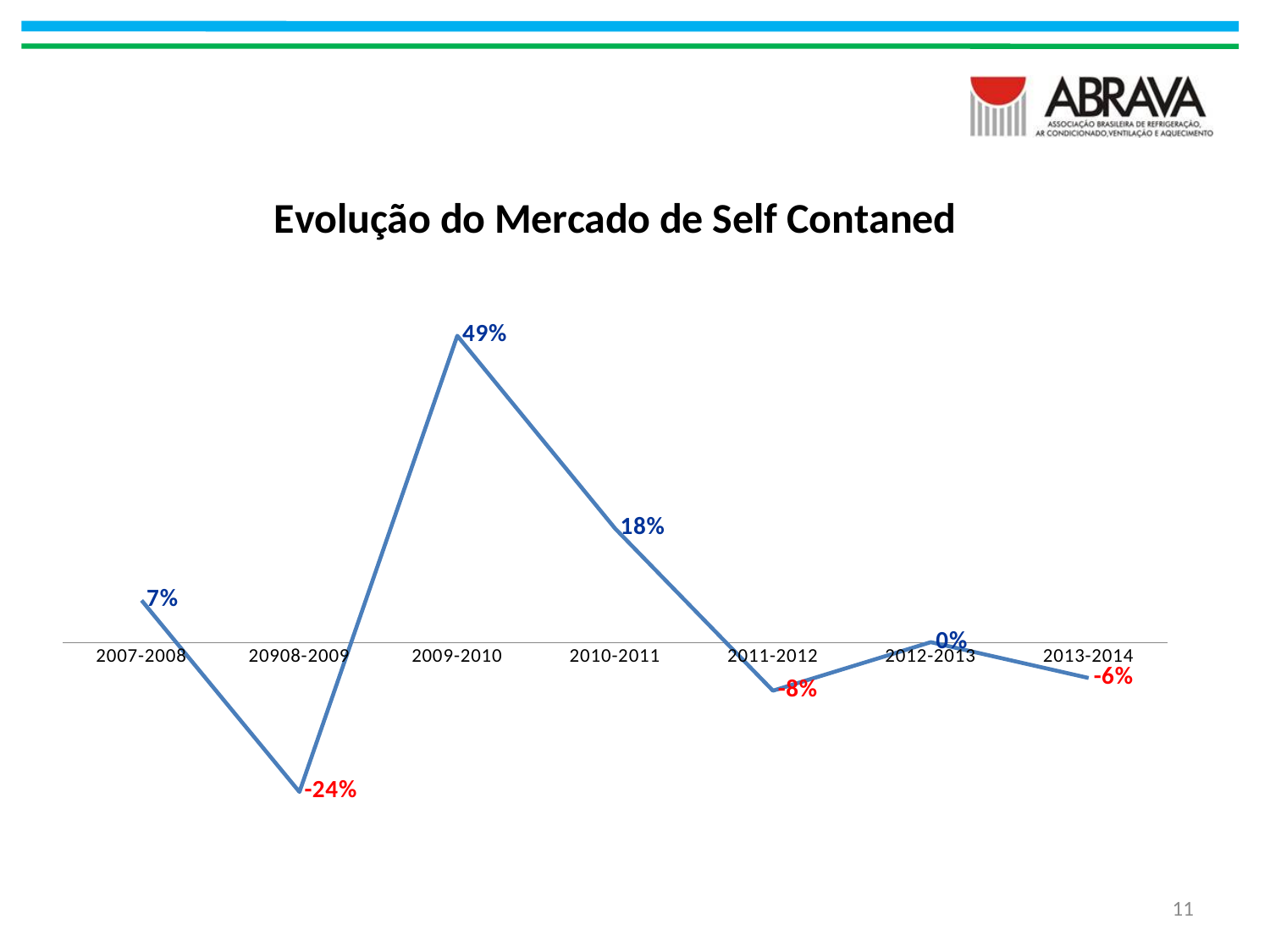
Which is larger, the value for 2010-2011 or the value for 2007-2008? 2010-2011 Which period has the highest value? 2009-2010 What is the value for 2009-2010? 49% What type of chart is shown on the slide? line chart What is the difference between the values for 2009-2010 and 2010-2011? 31% What is the value for 2007-2008? 7% How many periods are plotted on the x axis? 7 Does the value rise or fall from 2009-2010 to 2011-2012? fall What is the value for 2011-2012? -8% Which period has the lowest value? 20908-2009 What is the title of the chart? Evolução do Mercado de Self Contaned What is the value for 2013-2014? -6%